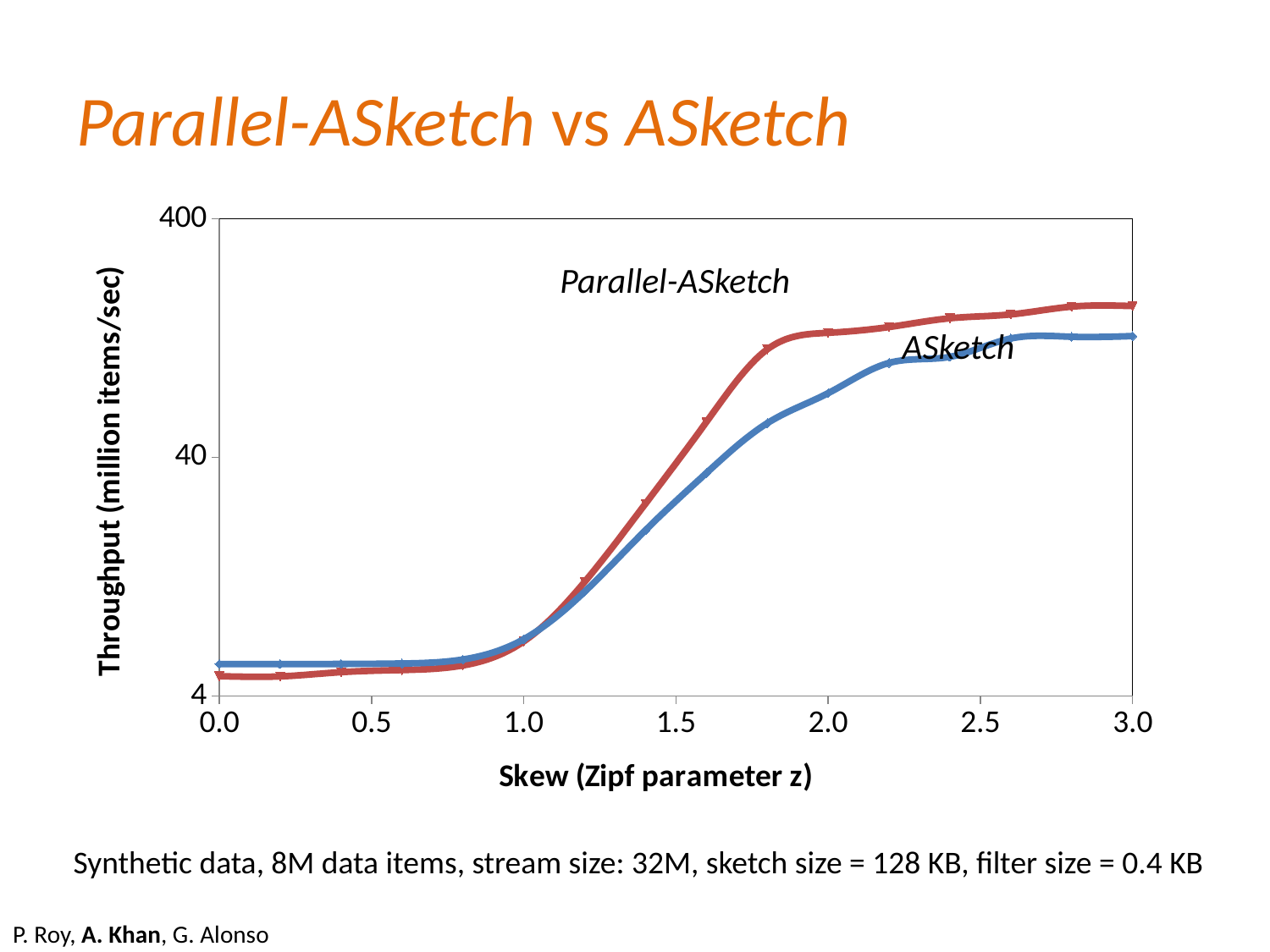
At skew 2.0, which series has the higher throughput, Parallel-ASketch or ASketch? Parallel-ASketch At skew 0.0, which series has the higher throughput, Parallel-ASketch or ASketch? ASketch How many series are plotted on the chart? 2 Does the throughput of Parallel-ASketch rise or fall as skew increases from 0.0 to 3.0? rise At skew 3.0, which series has the higher throughput, Parallel-ASketch or ASketch? Parallel-ASketch Is the throughput of Parallel-ASketch at skew 1.0 greater or less than 40? less Does the throughput of ASketch rise or fall as skew increases from 1.0 to 2.0? rise What kind of chart is shown on the slide? line chart Is the throughput of ASketch at skew 0.0 greater or less than 40? less What are the names of the two series plotted on the chart? Parallel-ASketch and ASketch Is the throughput of Parallel-ASketch at skew 3.0 greater or less than 40? greater What is the label of the y axis? Throughput (million items/sec)